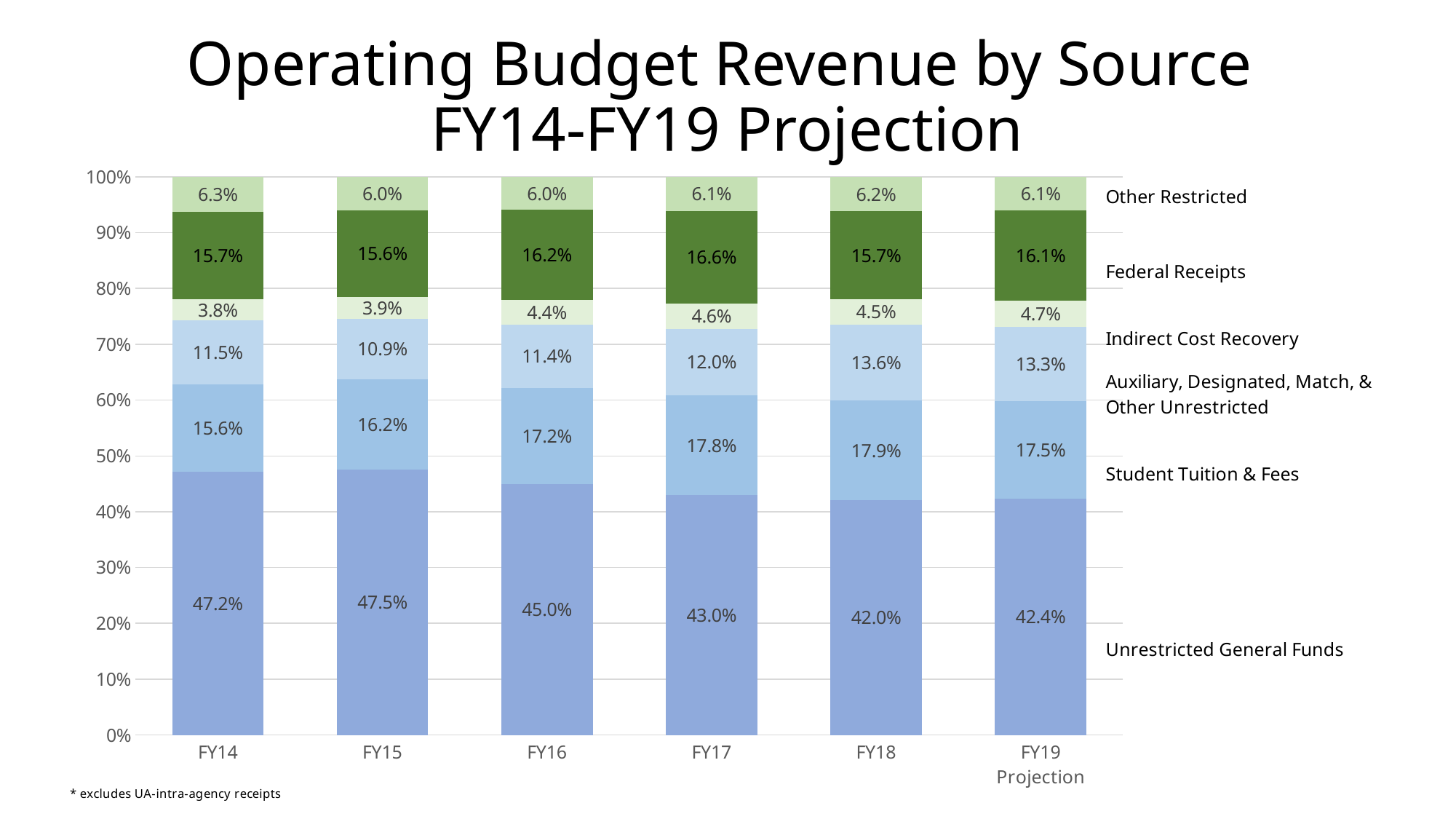
How does the Student Tuition & Fees share change from FY14 to FY18? It rises In which fiscal year is the Unrestricted General Funds share the lowest? FY18 In which fiscal year is the Unrestricted General Funds share the highest? FY15 What is the Federal Receipts share for FY17? 16.6% What is the Unrestricted General Funds share for FY14? 47.2% What is the Auxiliary, Designated, Match, & Other Unrestricted share for FY18? 13.6% How many revenue source series are shown in the chart? 6 In which fiscal year is the Indirect Cost Recovery share the lowest? FY14 What is the Student Tuition & Fees share for FY19 Projection? 17.5% How many fiscal years are shown on the x axis? 6 By how many percentage points does the Unrestricted General Funds share in FY14 exceed that in FY19 Projection? 4.8 percentage points In FY16, which is larger: the Federal Receipts share or the Student Tuition & Fees share? Student Tuition & Fees